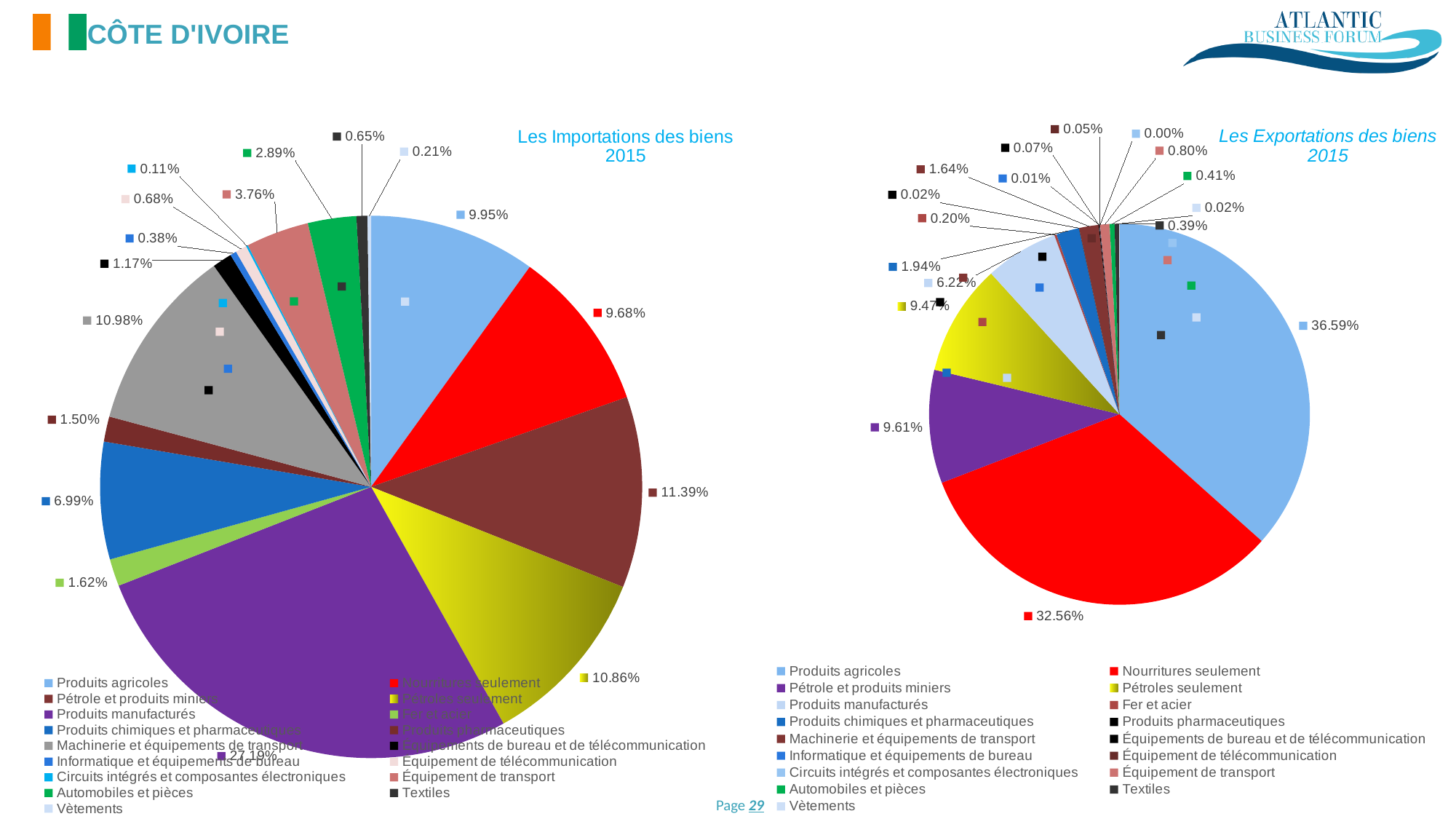
In the 'Les Importations des biens 2015' chart, what is the share of Produits manufacturés? 27.19% In the 'Les Importations des biens 2015' chart, which category has the largest share? Produits manufacturés In the 'Les Exportations des biens 2015' chart, which category has the largest share? Produits agricoles What is the title of the pie chart on the right side of the slide? Les Exportations des biens 2015 In the 'Les Importations des biens 2015' chart, which is larger: the share of Produits agricoles or the share of Fer et acier? Produits agricoles What kind of chart is used for 'Les Importations des biens 2015'? Pie chart In the 'Les Exportations des biens 2015' chart, what is the share of Nourritures seulement? 32.56% In the 'Les Importations des biens 2015' chart, what is the share of Pétrole et produits miniers? 11.39% In the 'Les Exportations des biens 2015' chart, what is the share of Produits manufacturés? 6.22% In the 'Les Exportations des biens 2015' chart, what is the difference between the shares of Produits agricoles and Nourritures seulement? 4.03% In the 'Les Importations des biens 2015' chart, what is the share of Produits chimiques et pharmaceutiques? 6.99% How many categories does the legend of the 'Les Exportations des biens 2015' chart list? 17